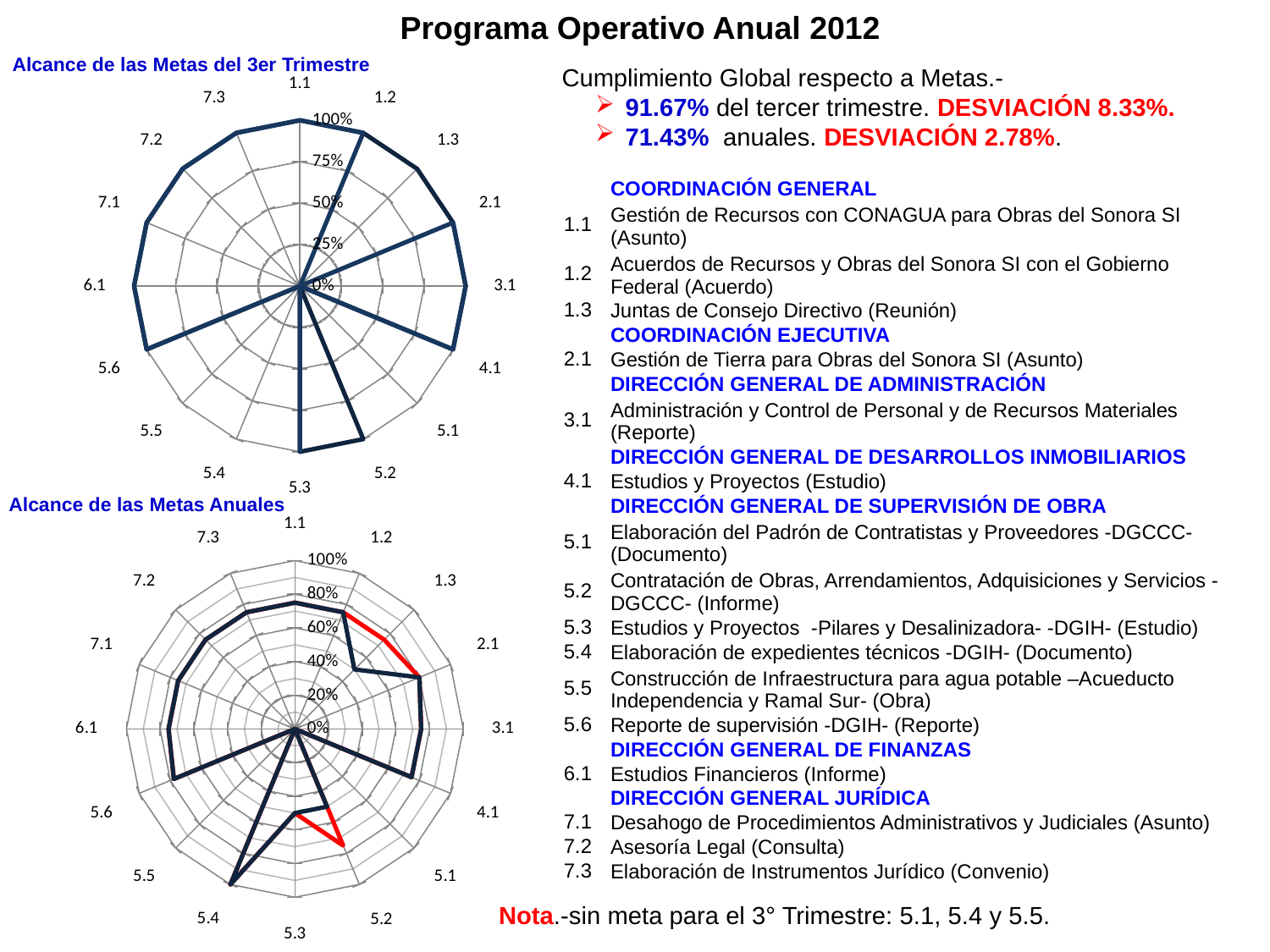
How many categories are plotted on the 'Alcance de las Metas Anuales' chart? 16 In the 'Alcance de las Metas del 3er Trimestre' chart, is the value for 5.1 greater or less than 50%? less What kind of chart is the 'Alcance de las Metas del 3er Trimestre' chart? Radar chart In the 'Alcance de las Metas del 3er Trimestre' chart, is the value for 5.4 greater or less than 25%? less How many categories are plotted on the 'Alcance de las Metas del 3er Trimestre' chart? 16 What is the title of the top chart on the slide? Alcance de las Metas del 3er Trimestre In the 'Alcance de las Metas del 3er Trimestre' chart, is the value for 6.1 greater or less than 75%? greater What kind of chart is the 'Alcance de las Metas Anuales' chart? Radar chart What is the highest percentage tick shown on the axis of the 'Alcance de las Metas Anuales' chart? 100%